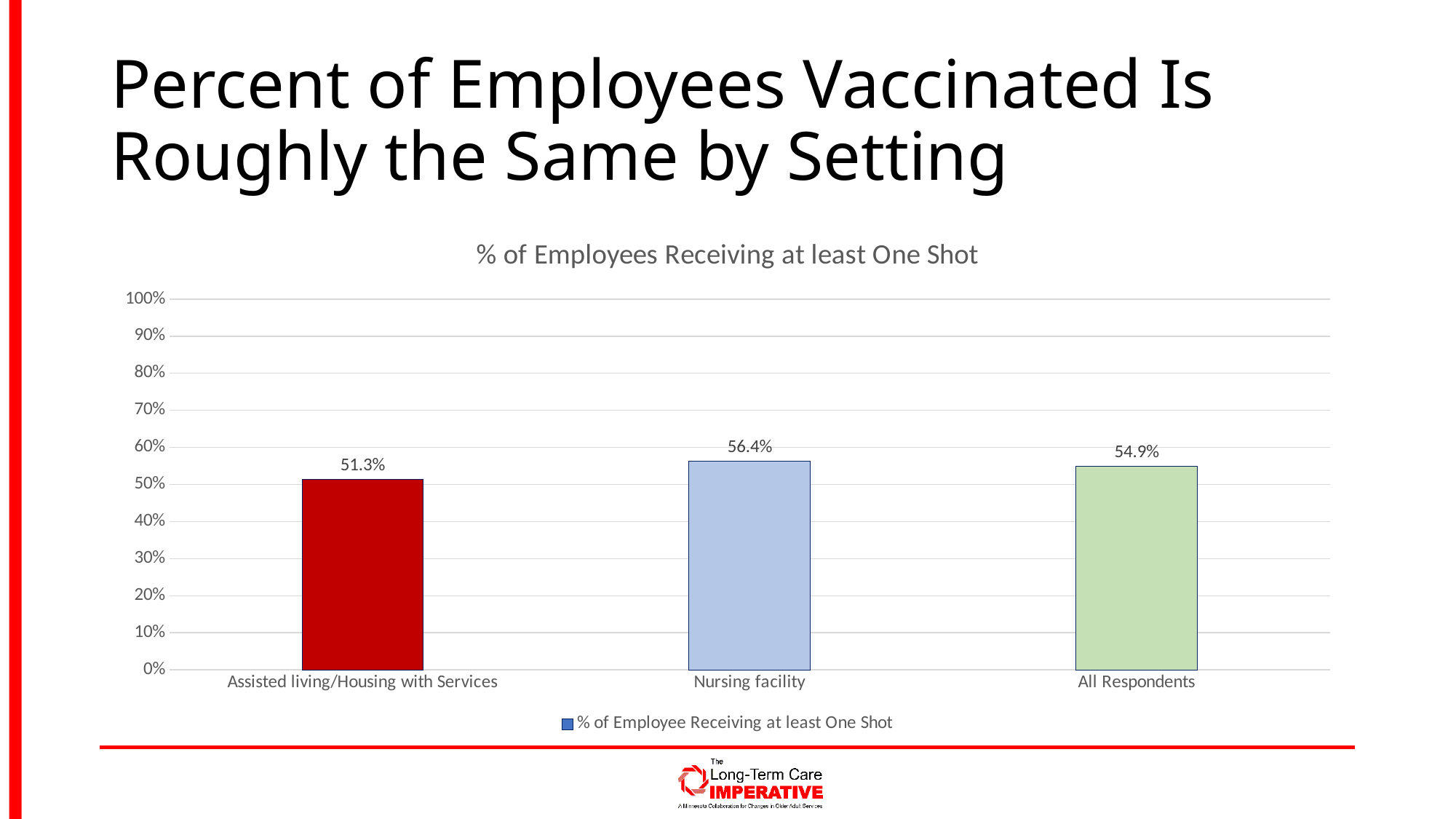
What is the value for All Respondents? 54.9% What is the value for Assisted living/Housing with Services? 51.3% Which category has the highest value? Nursing facility What is the difference between the values for Nursing facility and Assisted living/Housing with Services? 5.1% What kind of chart is shown on the slide? bar chart Which is larger, the value for All Respondents or the value for Assisted living/Housing with Services? All Respondents How many categories are shown on the x axis? 3 What is the value for Nursing facility? 56.4% Which category has the lowest value? Assisted living/Housing with Services What is the title of the chart? % of Employees Receiving at least One Shot Is the value for Nursing facility greater or less than 50%? greater What is the difference between the values for Nursing facility and All Respondents? 1.5%